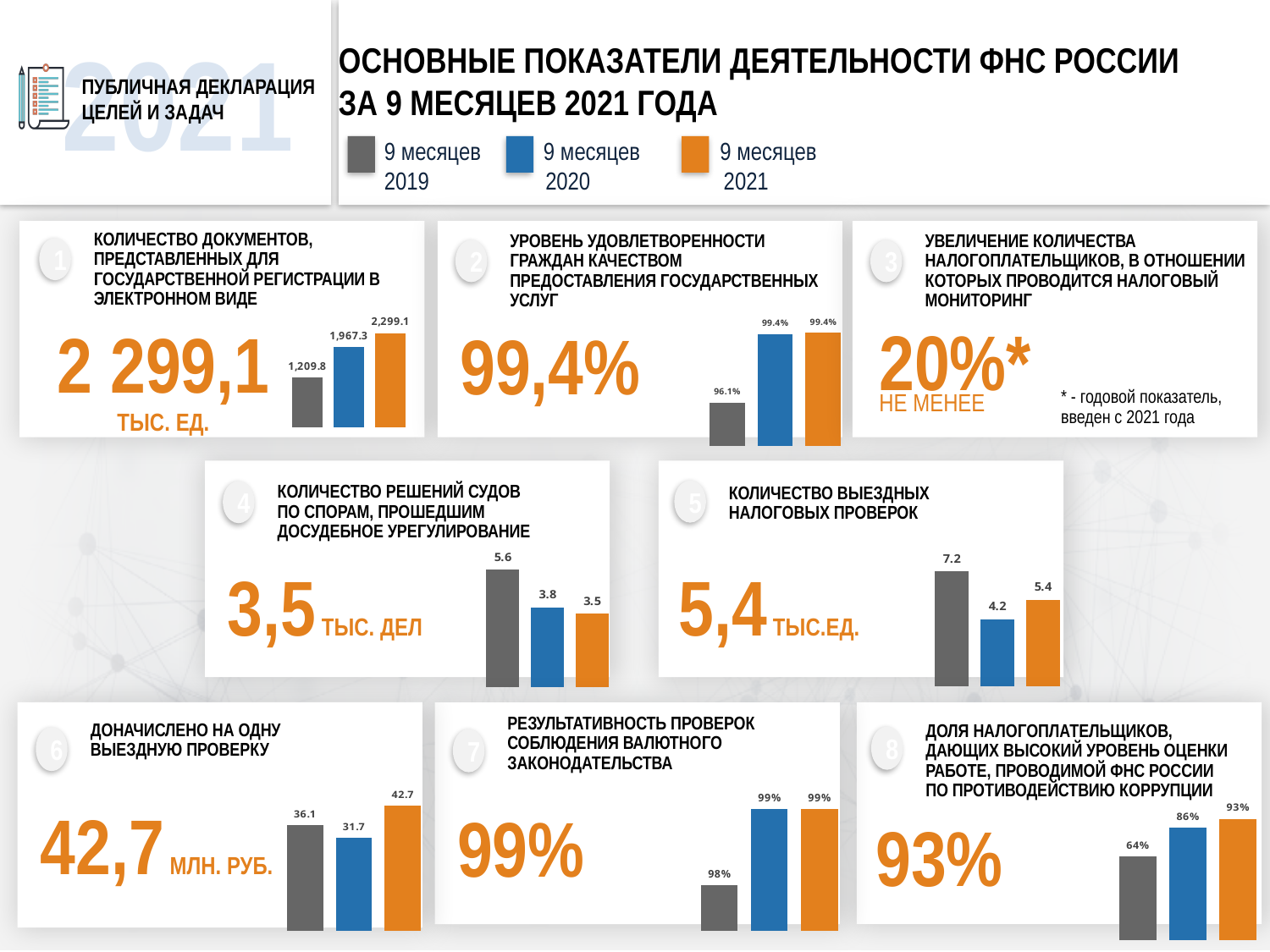
In the chart for 'Результативность проверок соблюдения валютного законодательства', what is the value for 9 месяцев 2019? 98% In the chart for 'Доля налогоплательщиков, дающих высокий уровень оценки работе, проводимой ФНС России по противодействию коррупции', what is the difference between the 9 месяцев 2021 and 9 месяцев 2019 values? 29% In the chart for 'Количество решений судов по спорам, прошедшим досудебное урегулирование', do the values rise or fall from 2019 to 2021? fall How many periods does the legend at the top of the slide list? 3 In the chart for 'Уровень удовлетворенности граждан качеством предоставления государственных услуг', what is the value for 9 месяцев 2019? 96.1% In the chart for 'Количество документов, представленных для государственной регистрации в электронном виде', what is the difference between the 9 месяцев 2021 and 9 месяцев 2020 values? 331.8 In the chart for 'Количество документов, представленных для государственной регистрации в электронном виде', what is the value for 9 месяцев 2019? 1,209.8 In the chart for 'Доначислено на одну выездную проверку', which is larger: the value for 9 месяцев 2019 or 9 месяцев 2020? 9 месяцев 2019 In the chart for 'Доначислено на одну выездную проверку', what is the difference between the 9 месяцев 2021 and 9 месяцев 2019 values? 6.6 In the chart for 'Количество выездных налоговых проверок', what is the value for 9 месяцев 2020? 4.2 In the chart for 'Количество решений судов по спорам, прошедшим досудебное урегулирование', which period has the highest value? 9 месяцев 2019 In the chart for 'Количество выездных налоговых проверок', which period has the lowest value? 9 месяцев 2020